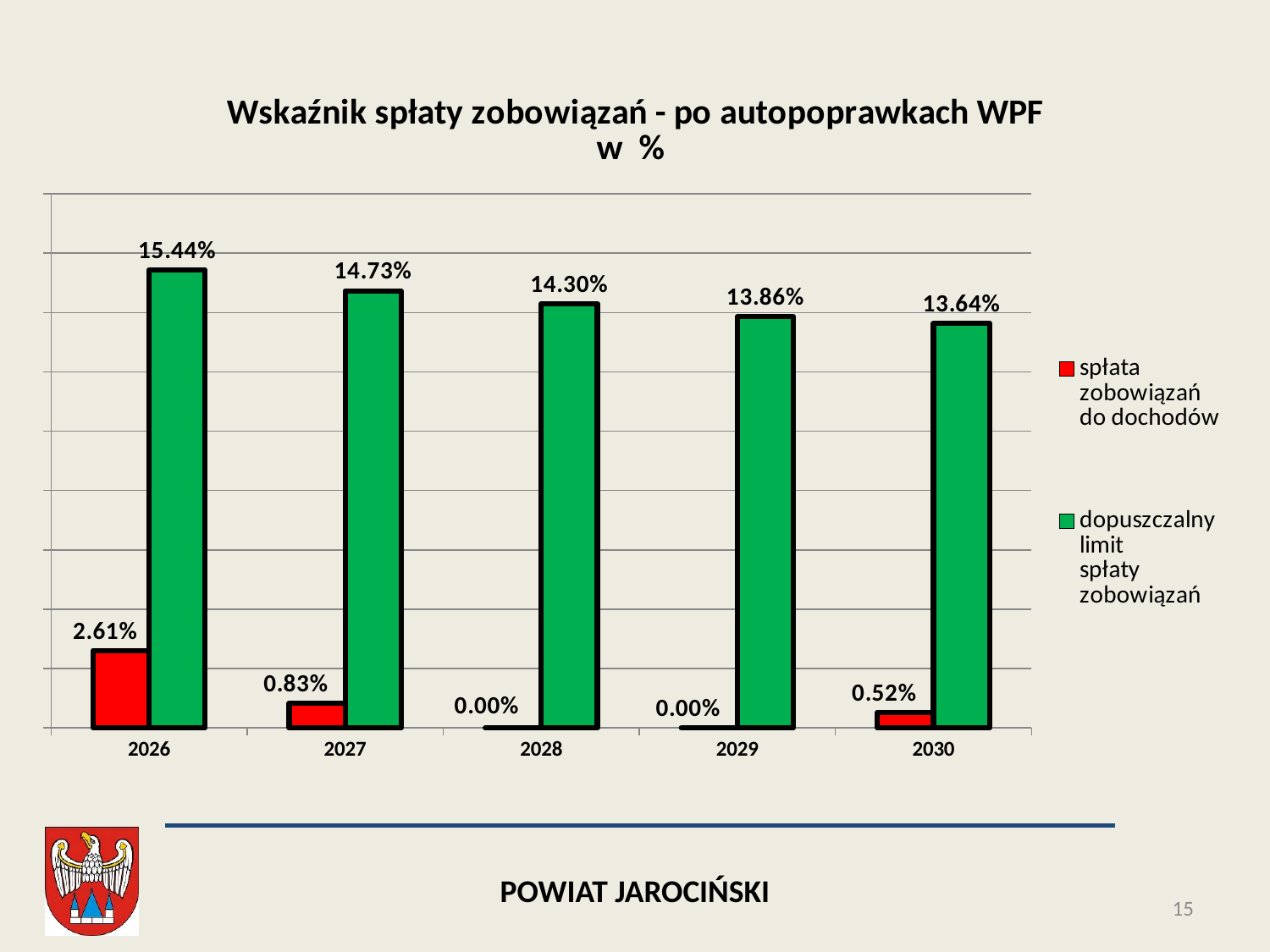
Does 'dopuszczalny limit spłaty zobowiązań' rise or fall from 2026 to 2030? fall How many series does the legend list? 2 In which year is 'spłata zobowiązań do dochodów' the highest? 2026 What is the difference between the 'dopuszczalny limit spłaty zobowiązań' values for 2027 and 2028? 0.43% What is the difference between 'dopuszczalny limit spłaty zobowiązań' and 'spłata zobowiązań do dochodów' in 2026? 12.83% How many years are shown on the x axis? 5 What is the value of 'dopuszczalny limit spłaty zobowiązań' for 2026? 15.44% Which is larger: 'spłata zobowiązań do dochodów' in 2027 or in 2030? 2027 In which year is 'dopuszczalny limit spłaty zobowiązań' the lowest? 2030 What is the value of 'spłata zobowiązań do dochodów' for 2030? 0.52% What is the value of 'dopuszczalny limit spłaty zobowiązań' for 2029? 13.86% What is the value of 'spłata zobowiązań do dochodów' for 2027? 0.83%